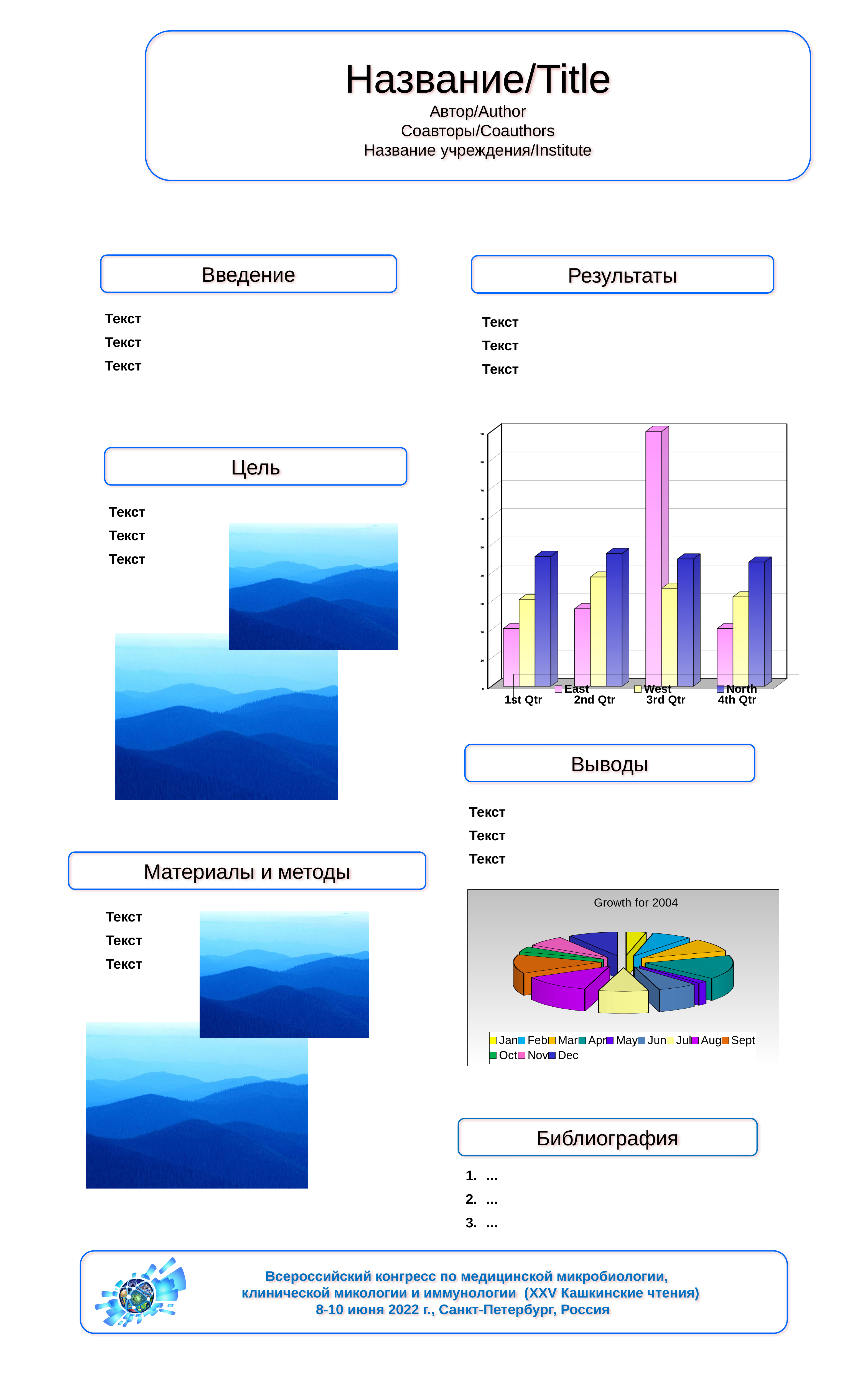
What kind of chart is the chart titled 'Growth for 2004'? pie chart In the bar chart with quarters on the x axis, is the North value for 2nd Qtr greater or less than 40? greater In the bar chart with quarters on the x axis, how many categories are shown on the x axis? 4 In the bar chart with quarters on the x axis, how many series does the legend list? 3 In the chart titled 'Growth for 2004', how many entries does the legend list? 12 What kind of chart is the upper chart on the right side of the slide (with 1st Qtr to 4th Qtr on the x axis)? bar chart In the bar chart with quarters on the x axis, which is larger for 1st Qtr: the East value or the North value? North In the bar chart with quarters on the x axis, is the East value for 3rd Qtr greater or less than 80? greater In the bar chart with quarters on the x axis, which quarter has the highest East value? 3rd Qtr In the bar chart with quarters on the x axis, which series is shown in pink? East What is the title of the pie chart on the slide? Growth for 2004 In the bar chart with quarters on the x axis, is the East value for 1st Qtr greater or less than 30? less